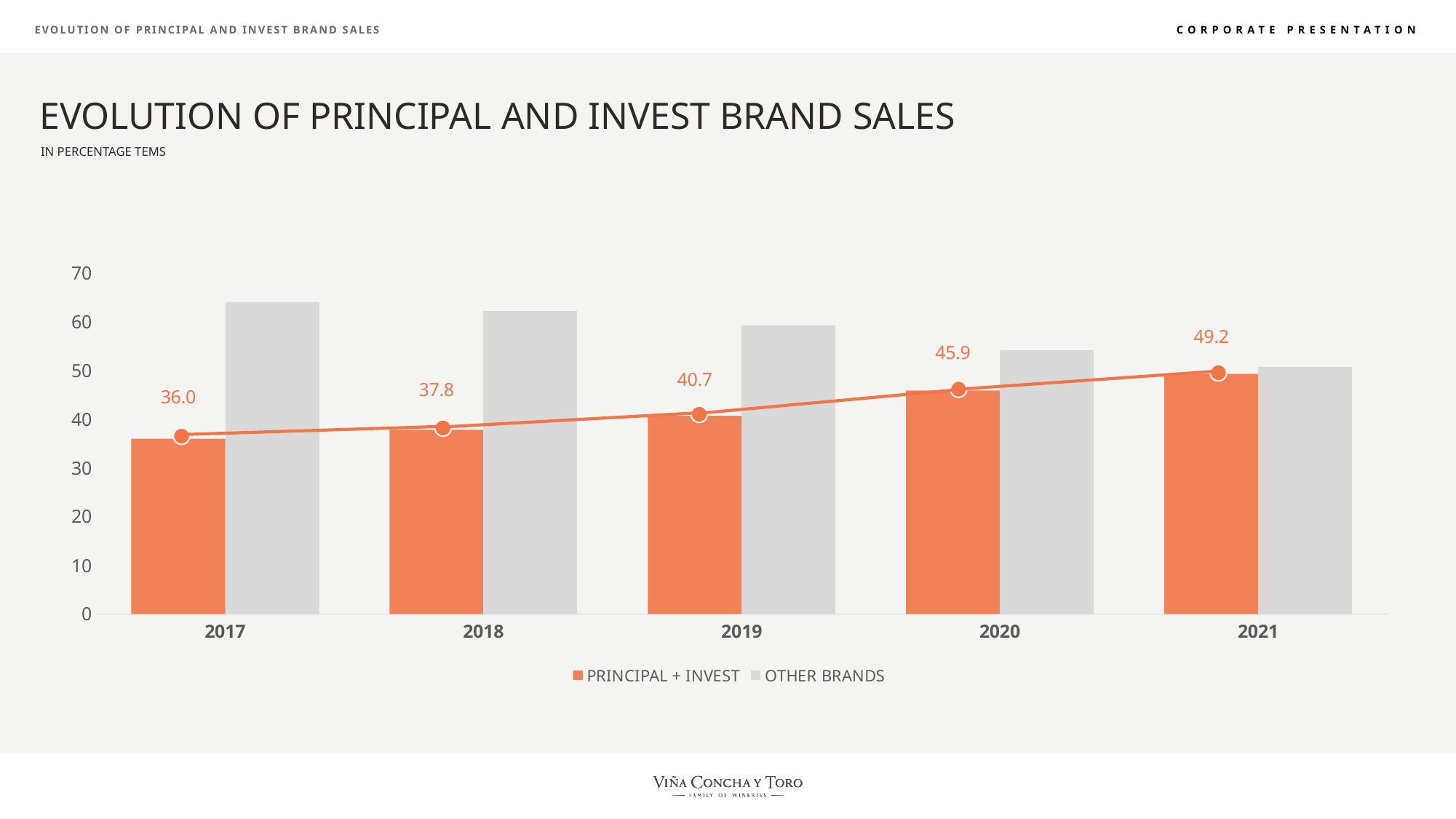
Is the OTHER BRANDS value for 2020 greater or less than 60? less What is the PRINCIPAL + INVEST value for 2017? 36.0 How many series does the legend list? 2 What is the PRINCIPAL + INVEST value for 2021? 49.2 Which is larger in 2018, the PRINCIPAL + INVEST bar or the OTHER BRANDS bar? OTHER BRANDS Does the PRINCIPAL + INVEST value rise or fall from 2017 to 2021? rise In which year is the PRINCIPAL + INVEST value lowest? 2017 What is the difference between the PRINCIPAL + INVEST values for 2021 and 2017? 13.2 Is the OTHER BRANDS value for 2017 greater or less than 60? greater How many years are shown on the x axis? 5 In which year is the PRINCIPAL + INVEST value highest? 2021 What is the PRINCIPAL + INVEST value for 2019? 40.7